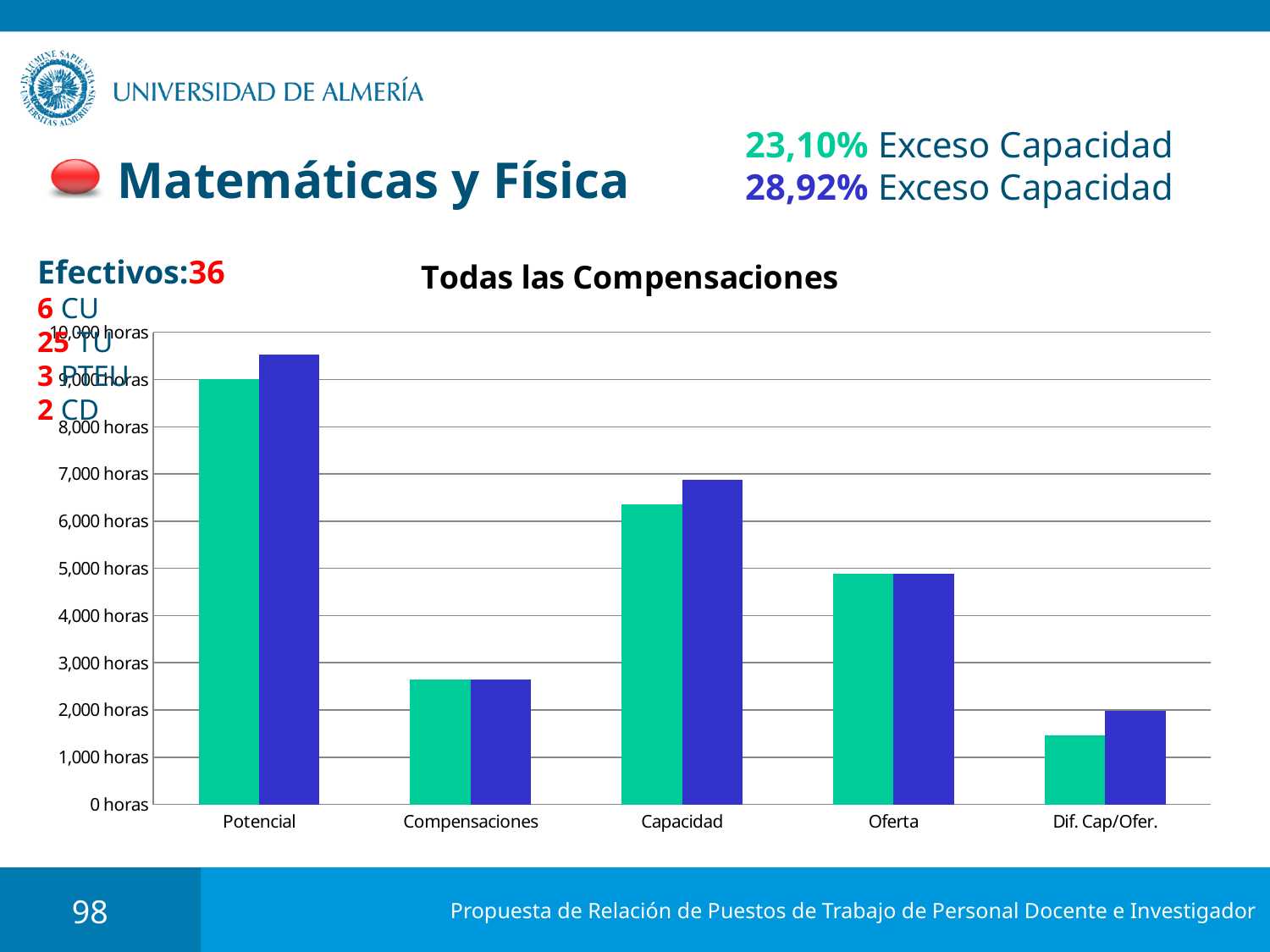
Is the blue bar for Dif. Cap/Ofer. greater or less than 3,000 horas? less Is the blue bar for Capacidad greater or less than 6,000 horas? greater What two colours are used for the bars in the chart? green and blue Which category has the tallest bars in the chart? Potencial What kind of chart is shown on the slide? bar chart Is the green bar for Compensaciones greater or less than 3,000 horas? less Which category has larger bars, Capacidad or Oferta? Capacidad For Potencial, which bar is taller, the green one or the blue one? the blue one Which category has the shortest bars in the chart? Dif. Cap/Ofer. What is the title of the chart? Todas las Compensaciones How many categories are shown on the x axis of the chart? 5